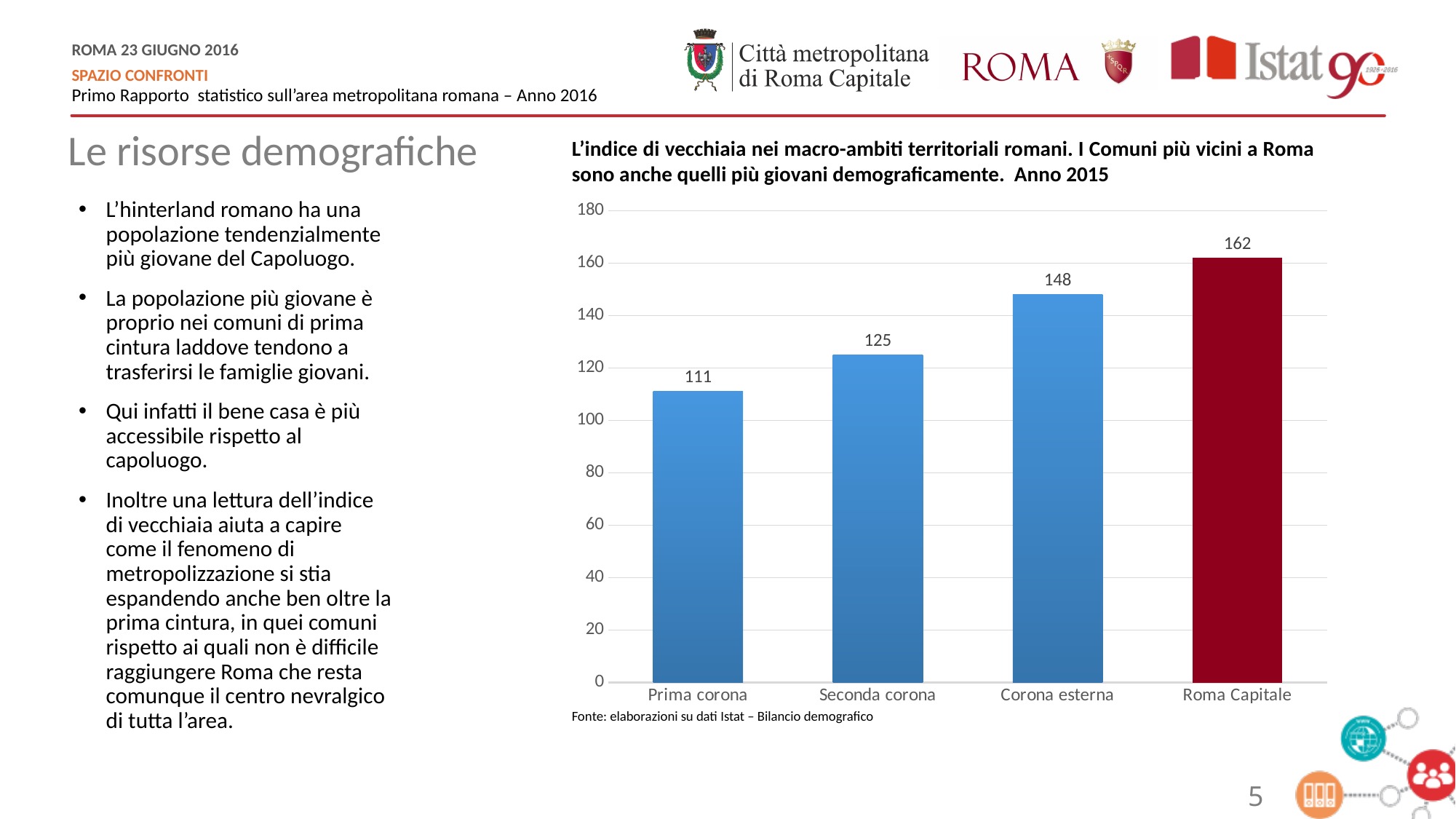
What is the value for Roma Capitale? 162 What is the difference between the values for Corona esterna and Seconda corona? 23 What is the value for Corona esterna? 148 What is the value for Prima corona? 111 What is the value for Seconda corona? 125 Which category has the lowest value? Prima corona Which is larger, the value for Seconda corona or the value for Corona esterna? Corona esterna What is the difference between the values for Roma Capitale and Prima corona? 51 Which category has the highest value? Roma Capitale What kind of chart is shown on the slide? bar chart How many categories are shown on the x axis? 4 Do the values rise or fall from left to right along the x axis? rise